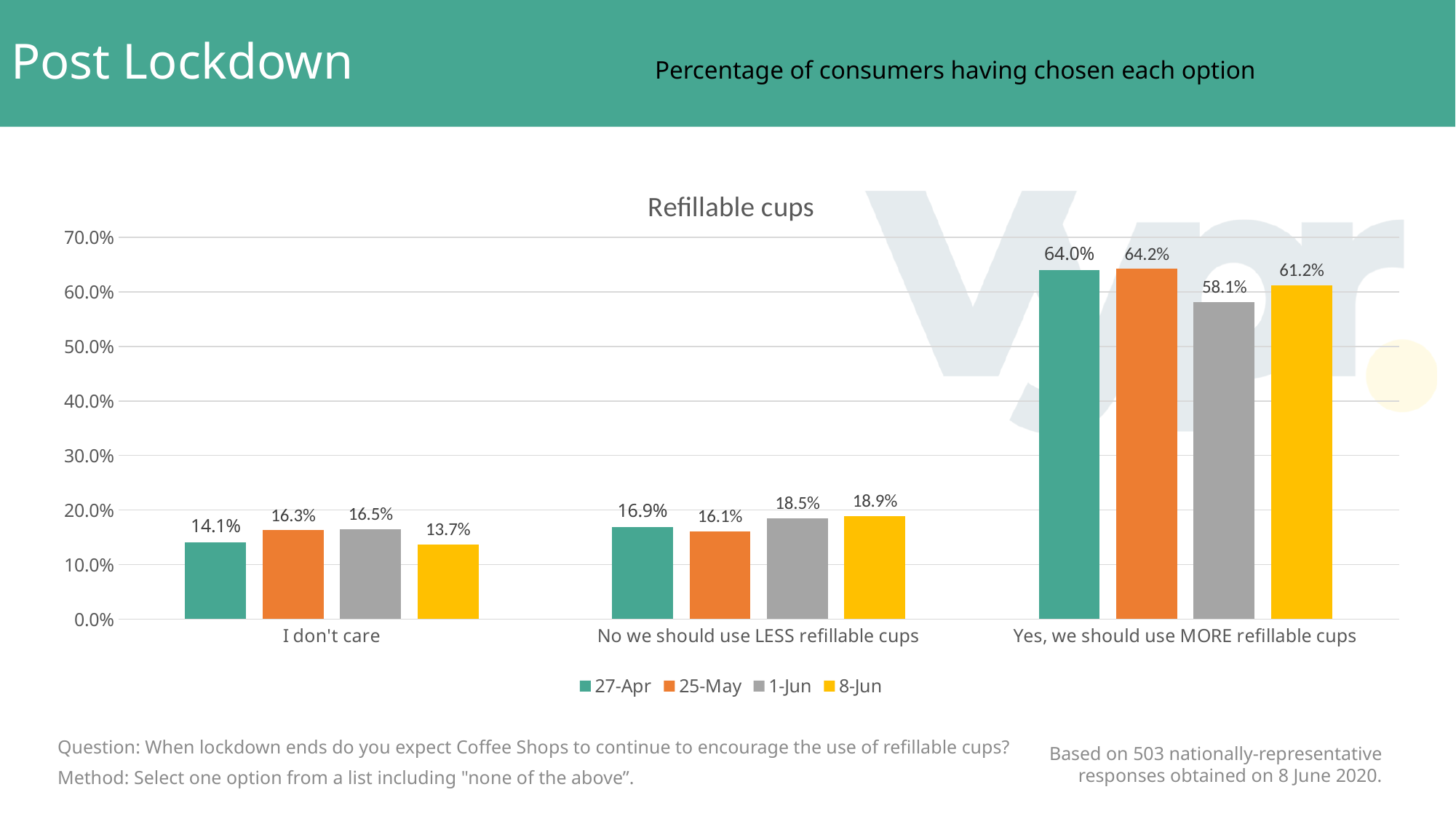
What is the value for 8-Jun in the 'Yes, we should use MORE refillable cups' category? 61.2% Is the 1-Jun value for 'Yes, we should use MORE refillable cups' greater or less than 60.0%? less How many series does the legend list? 4 How many categories are shown on the x axis? 3 What kind of chart is shown on the slide? bar chart Which is larger in the 'No we should use LESS refillable cups' category: the 27-Apr value or the 8-Jun value? 8-Jun Which category has the highest value for the 25-May series? Yes, we should use MORE refillable cups What is the value for 1-Jun in the 'No we should use LESS refillable cups' category? 18.5% What is the difference between the 27-Apr and 1-Jun values in the 'Yes, we should use MORE refillable cups' category? 5.9% What is the value for 27-Apr in the 'I don't care' category? 14.1% What is the title of the chart? Refillable cups Which series has the lowest value in the 'I don't care' category? 8-Jun